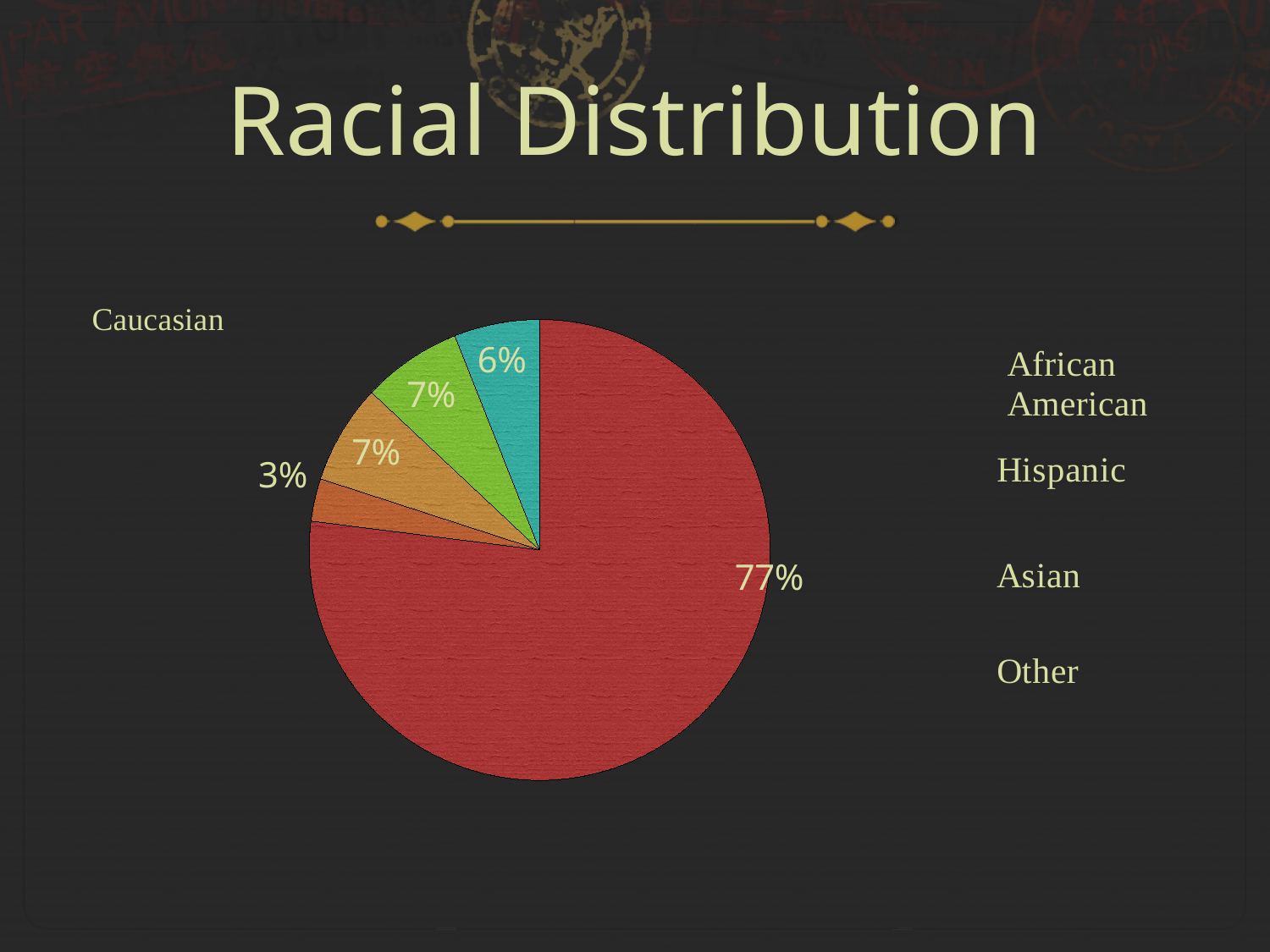
How many slices of the pie chart are labelled 7%? 2 Which is larger, the 6% slice or the 3% slice? The 6% slice What is the title of the chart? Racial Distribution How many slices does the pie chart have? 5 What is the largest percentage shown on the pie chart? 77% What do the four smaller slices (3%, 7%, 7%, 6%) add up to? 23% Which racial group makes up the largest share of the pie chart? Caucasian What is the difference between the largest slice (77%) and the smallest slice (3%)? 74 percentage points What kind of chart is shown on the slide? Pie chart What percentage of the pie chart is Caucasian? 77% What is the smallest percentage shown on the pie chart? 3% What colour is the largest slice of the pie chart? Red